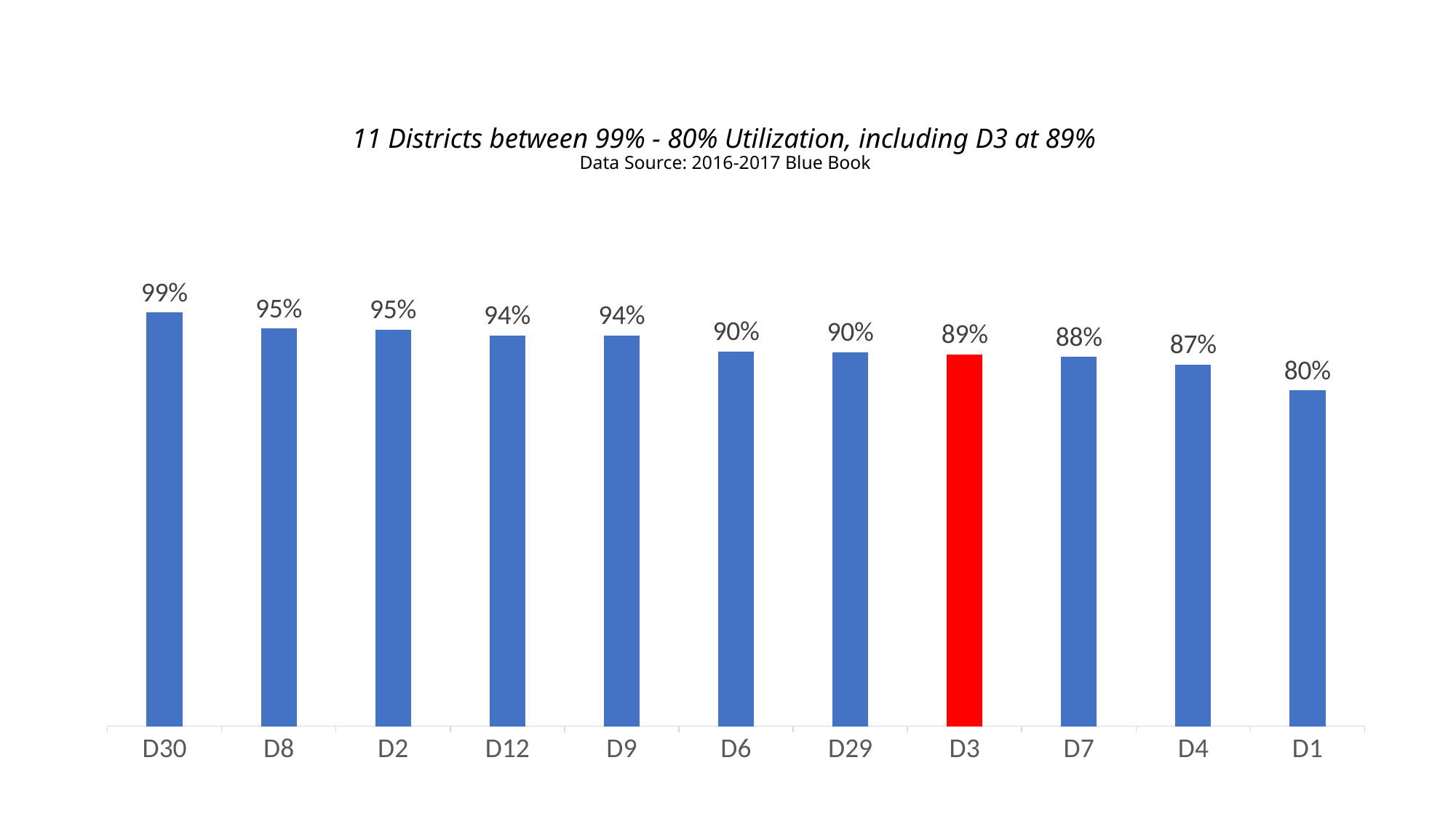
What is the difference between the utilization of D8 and D3? 6% Which has a higher utilization, D7 or D1? D7 What is the difference between the utilization of D30 and D1? 19% What is the utilization value for D30? 99% Which district's bar is coloured red? D3 What is the utilization value for D12? 94% What is the utilization value for D3? 89% What is the utilization value for D4? 87% How many districts are shown in the chart? 11 Which district has the lowest utilization? D1 Which district has the highest utilization? D30 What kind of chart is shown on the slide? Bar chart